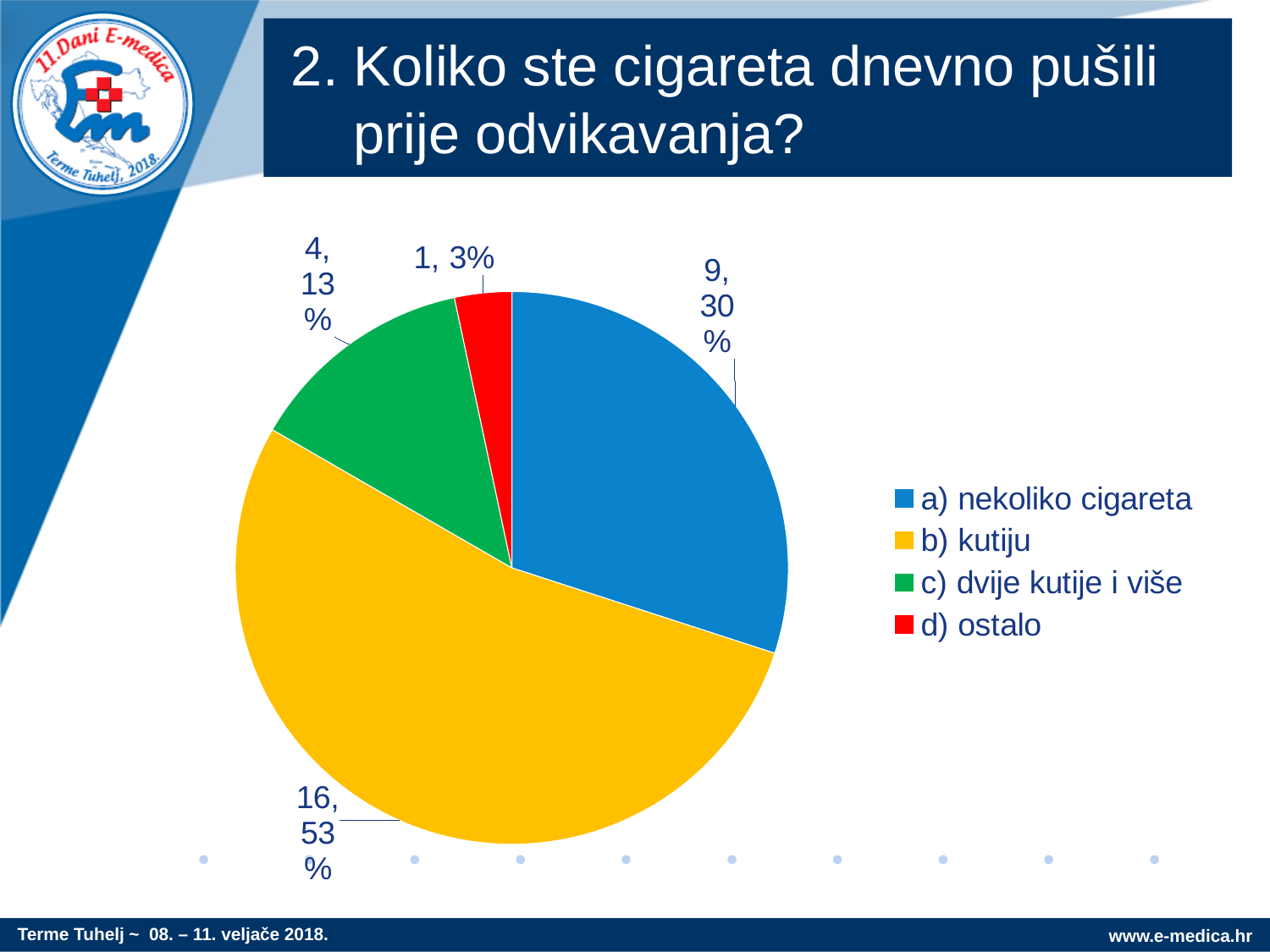
How many slices does the pie chart have? 4 Which is larger, the slice for 'a) nekoliko cigareta' or the slice for 'c) dvije kutije i više'? a) nekoliko cigareta What is the count for 'b) kutiju'? 16 What kind of chart is shown on the slide? pie chart How many entries does the legend list? 4 Which category has the smallest slice? d) ostalo What percentage share does 'a) nekoliko cigareta' have? 30% What colour is the slice for 'c) dvije kutije i više'? green Which category has the largest slice? b) kutiju What is the difference in count between 'b) kutiju' and 'a) nekoliko cigareta'? 7 What percentage share does 'd) ostalo' have? 3% What is the count for 'c) dvije kutije i više'? 4